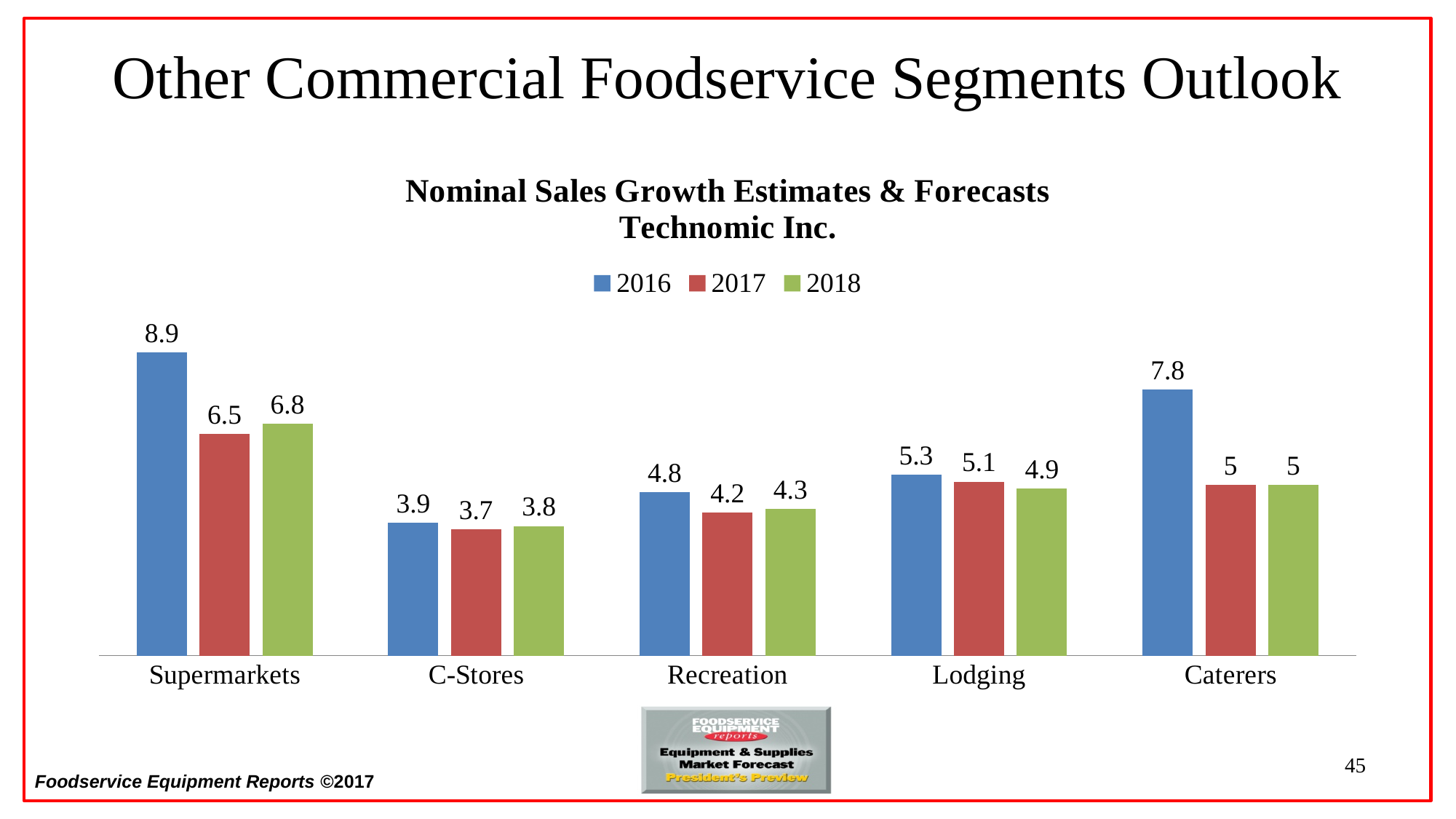
Which category has the lowest 2017 value? C-Stores Do the values for Lodging rise or fall from 2016 to 2018? Fall What is the difference between the 2016 values for Caterers and Lodging? 2.5 How many series does the legend list? 3 How many categories are shown on the x axis? 5 Which category has the highest 2016 value? Supermarkets What is the 2018 value for Lodging? 4.9 What is the 2016 value for Supermarkets? 8.9 What kind of chart is shown? Bar chart What is the 2017 value for Recreation? 4.2 Which is larger, the 2018 value for Supermarkets or the 2018 value for Caterers? Supermarkets What is the difference between the 2016 and 2017 values for Supermarkets? 2.4